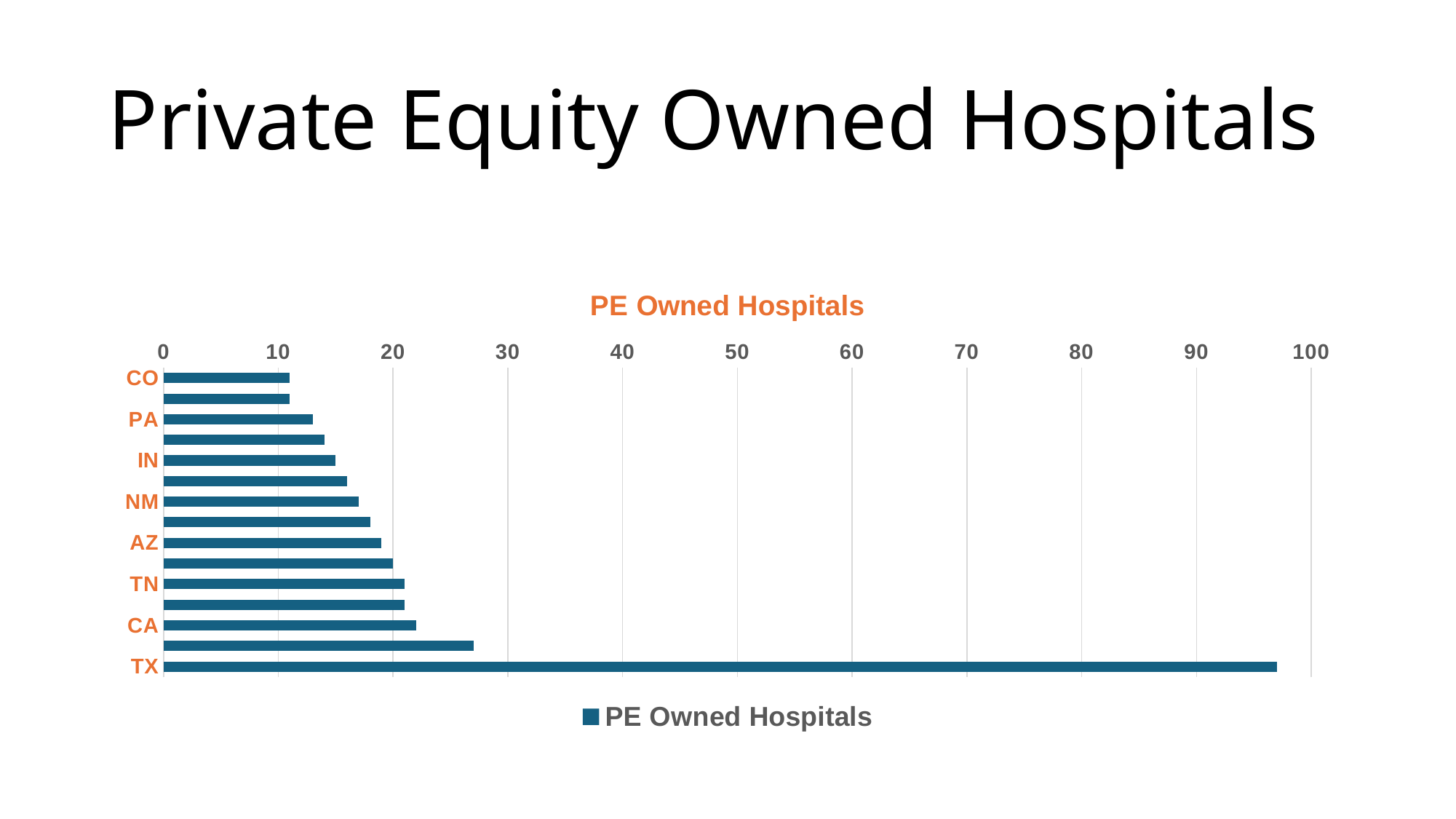
How many series does the legend list? 1 Is the value for CO greater or less than 20? less Is the value for TX greater or less than 90? greater Which state has the highest number of PE owned hospitals? TX Which has more PE owned hospitals, CO or NM? NM Which has more PE owned hospitals, PA or AZ? AZ What kind of chart is shown on the slide? bar chart Which has more PE owned hospitals, TX or CA? TX Is the value for NM greater or less than 20? less How many state labels are shown on the vertical axis? 8